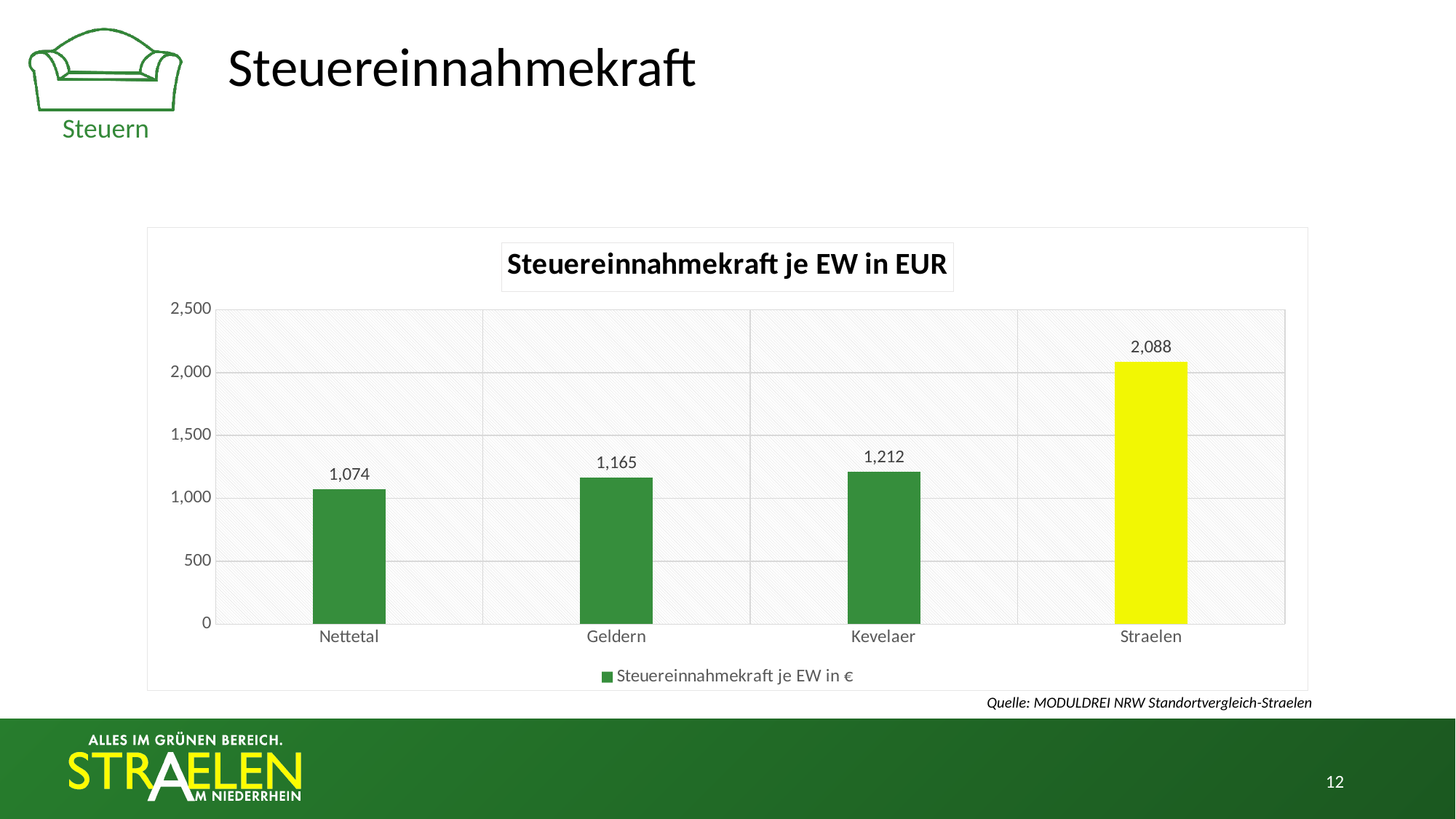
What is the difference between the values for Straelen and Kevelaer? 876 Which has a higher Steuereinnahmekraft je EW, Kevelaer or Geldern? Kevelaer What is the Steuereinnahmekraft je EW in EUR for Straelen? 2,088 What is the difference between the values for Geldern and Nettetal? 91 Which municipality has the lowest Steuereinnahmekraft je EW? Nettetal How many municipalities are shown in the chart? 4 What is the Steuereinnahmekraft je EW in EUR for Nettetal? 1,074 What is the Steuereinnahmekraft je EW in EUR for Kevelaer? 1,212 Which municipality has the highest Steuereinnahmekraft je EW? Straelen What is the Steuereinnahmekraft je EW in EUR for Geldern? 1,165 Is the value for Straelen greater or less than 2,000? greater What type of chart is shown on the slide? Bar chart